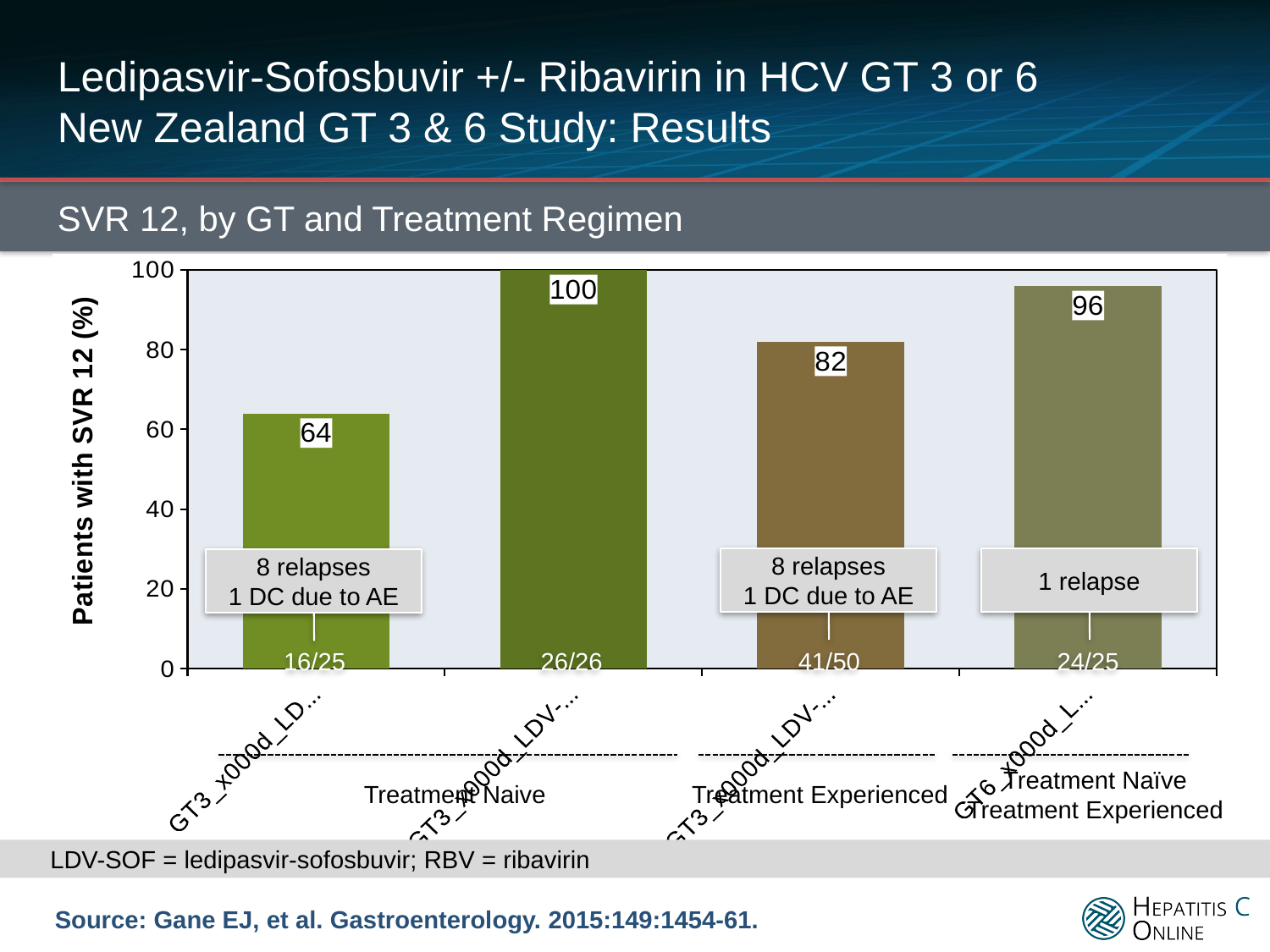
What is the SVR 12 value shown on the first (leftmost) bar? 64 What type of chart is shown on the slide? Bar chart What is the label of the y-axis? Patients with SVR 12 (%) What is the SVR 12 value shown on the bar labeled 26/26? 100 What is the SVR 12 value shown on the fourth (rightmost) bar? 96 Which bar has the lowest SVR 12 value? The first bar (16/25), at 64 Which is larger, the SVR 12 value of the bar labeled 24/25 or the bar labeled 41/50? The bar labeled 24/25 (96) What is the difference between the SVR 12 values of the bar labeled 41/50 and the bar labeled 16/25? 18 Which bar has the highest SVR 12 value? The second bar (26/26), at 100 What is the SVR 12 value shown on the bar labeled 41/50? 82 How many bars are plotted in the chart? 4 Is the value for the first bar greater or less than 80? less